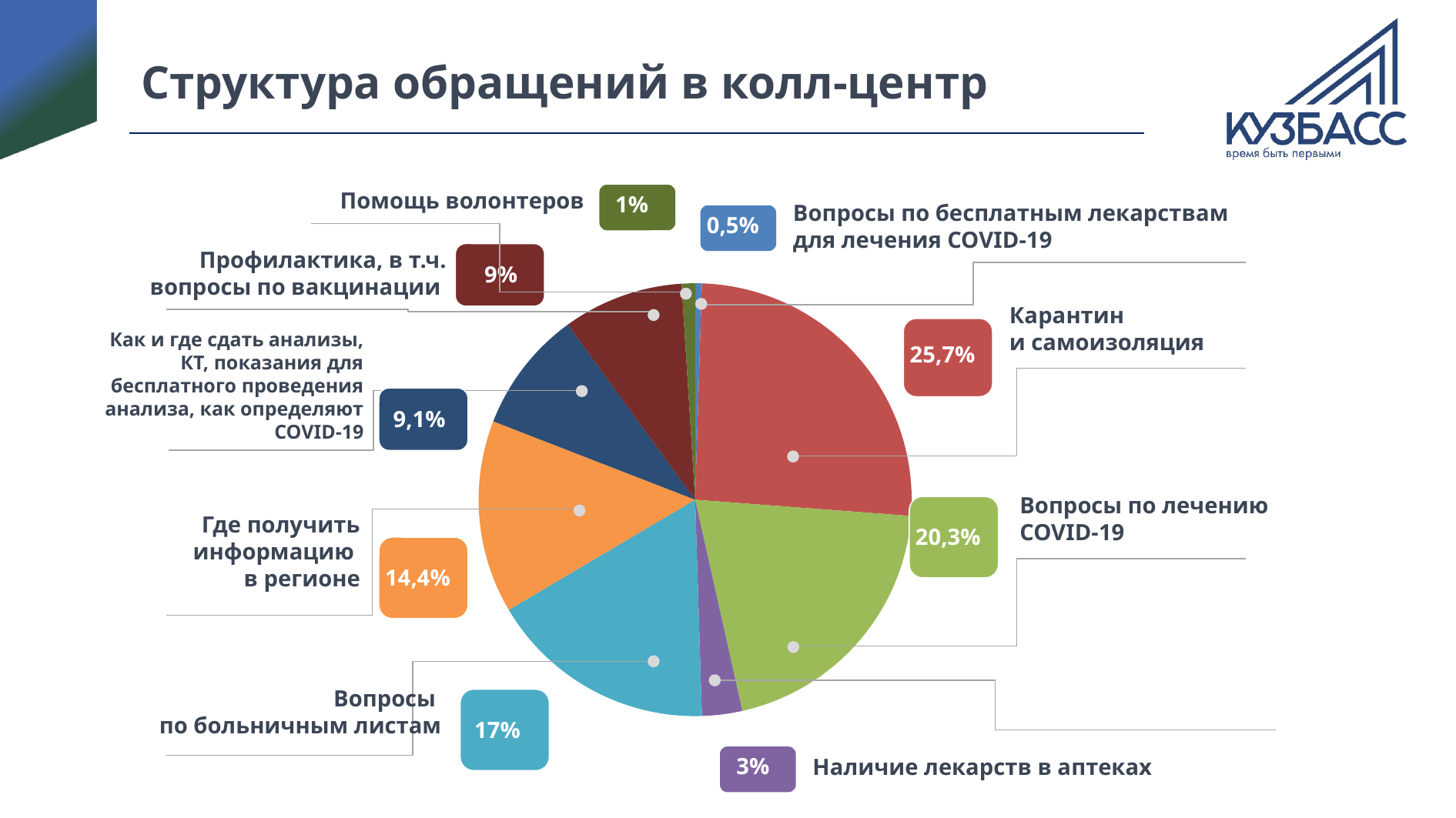
What kind of chart is shown on the slide? Pie chart What share of calls is for «Вопросы по лечению COVID-19»? 20,3% What is the title of the slide? Структура обращений в колл-центр What share of calls is for «Карантин и самоизоляция»? 25,7% What share of calls is for «Наличие лекарств в аптеках»? 3% What is the difference between the shares for «Карантин и самоизоляция» and «Вопросы по лечению COVID-19»? 5,4% Which category has the smallest share of calls? Вопросы по бесплатным лекарствам для лечения COVID-19 What share of calls is for «Где получить информацию в регионе»? 14,4% Which is larger: the share for «Вопросы по больничным листам» or for «Где получить информацию в регионе»? Вопросы по больничным листам How many categories does the pie chart show? 9 Which category has the largest share of calls? Карантин и самоизоляция What share of calls is for «Вопросы по больничным листам»? 17%